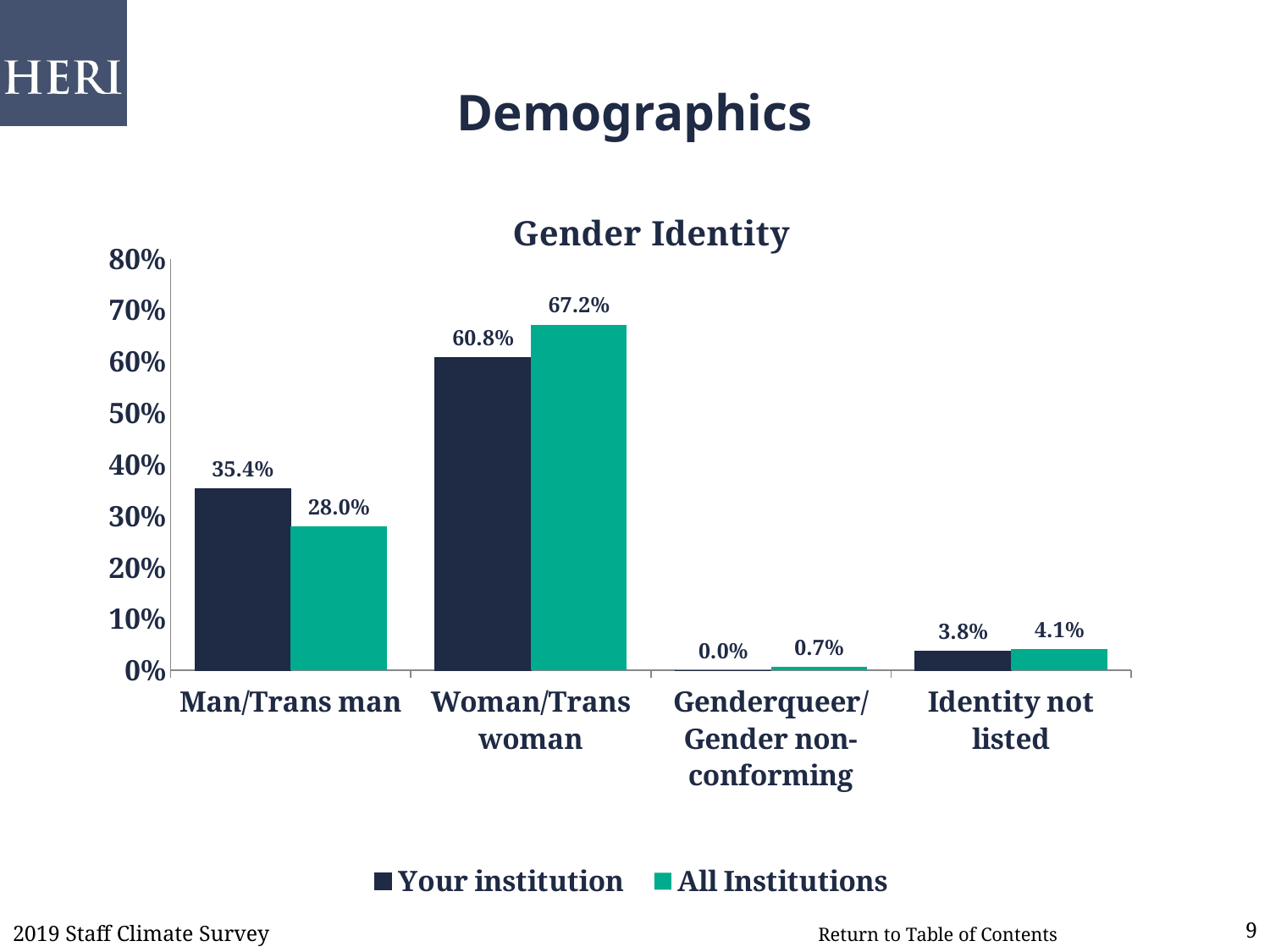
What is the value for All Institutions in the Genderqueer/Gender non-conforming category? 0.7% What is the value for All Institutions in the Woman/Trans woman category? 67.2% How many categories are shown on the x axis? 4 Which category has the lowest value for All Institutions? Genderqueer/Gender non-conforming Is the value for All Institutions in the Man/Trans man category greater or less than 30%? less What is the value for Your institution in the Identity not listed category? 3.8% What is the value for Your institution in the Man/Trans man category? 35.4% How many series does the legend list? 2 Which category has the highest value for Your institution? Woman/Trans woman What type of chart is shown on the slide? Bar chart What is the difference between the Your institution and All Institutions values for Man/Trans man? 7.4% Which is larger for Woman/Trans woman: Your institution or All Institutions? All Institutions